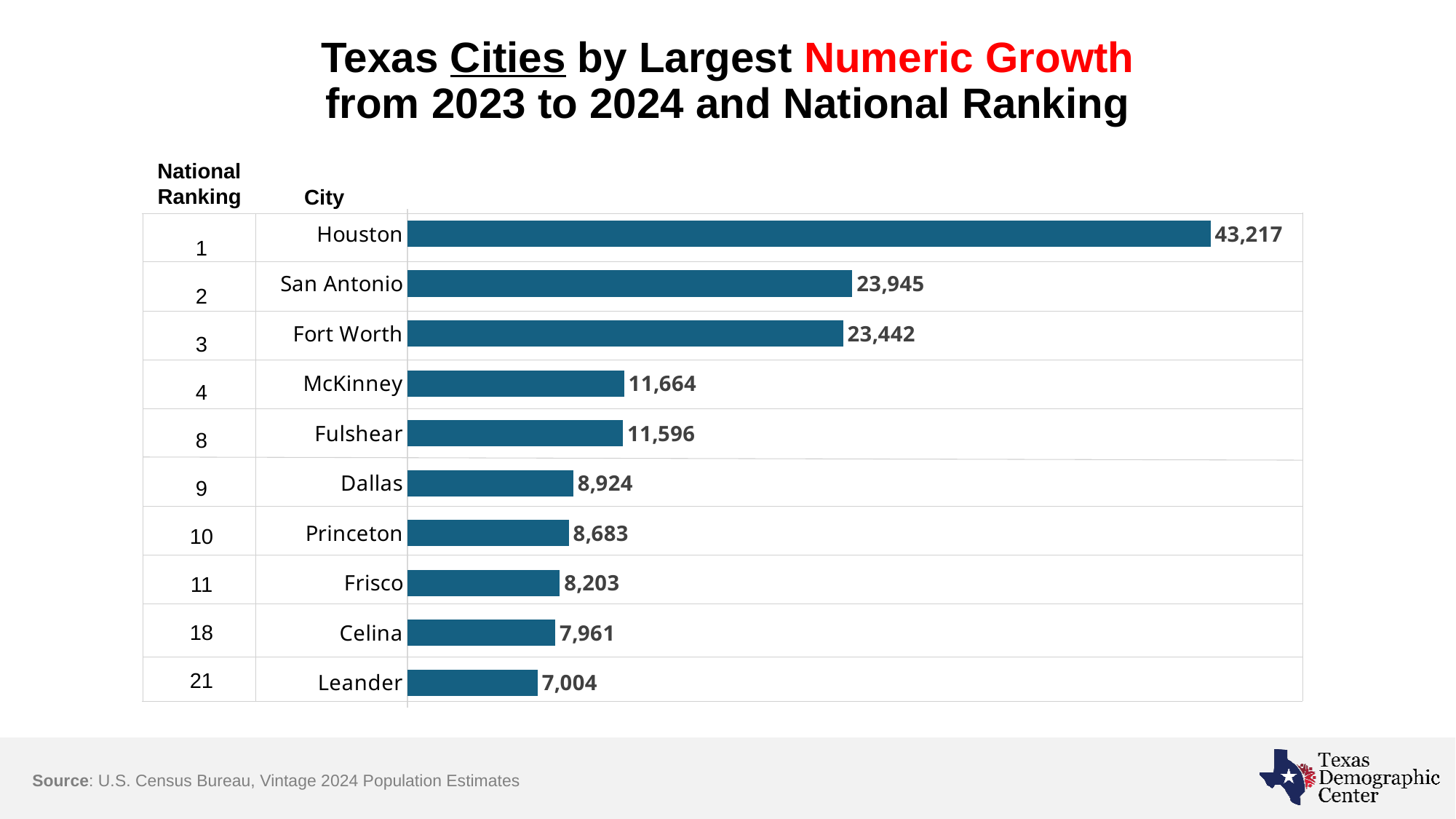
What is the numeric growth value shown for Leander? 7,004 What source is cited for the data on the slide? U.S. Census Bureau, Vintage 2024 Population Estimates What is the national ranking shown for Celina? 18 What kind of chart is shown on the slide? Bar chart Which city has the smallest numeric growth on the chart? Leander What is the difference between the numeric growth of Dallas and Frisco? 721 How many cities are shown on the chart? 10 Which city has the largest numeric growth on the chart? Houston Which city has a larger numeric growth, Fort Worth or McKinney? Fort Worth What is the difference between the numeric growth of Houston and San Antonio? 19,272 What is the numeric growth value shown for Fulshear? 11,596 What is the numeric growth value shown for Houston? 43,217